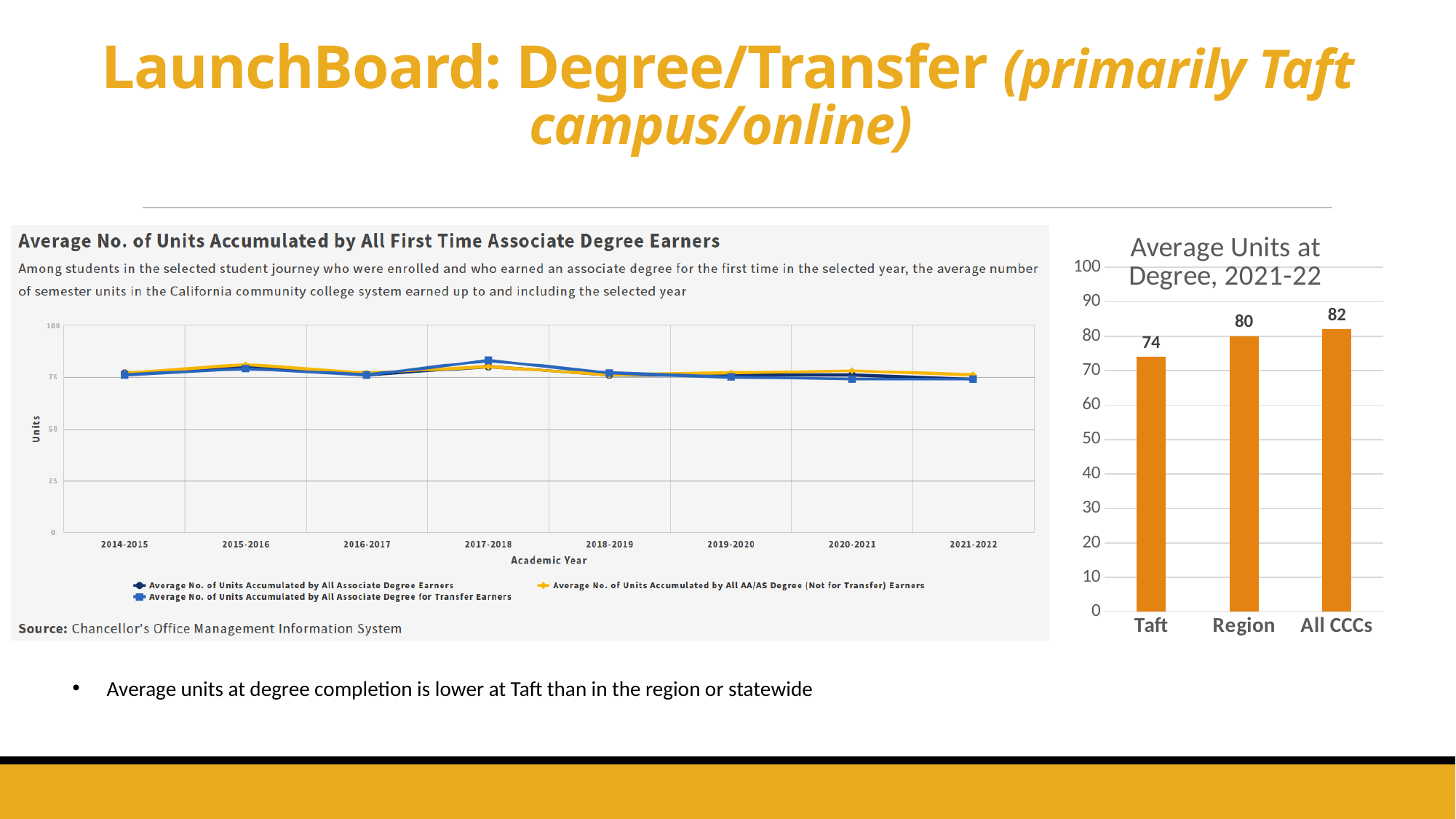
What kind of chart is the chart on the right of the slide? Bar chart In the 'Average Units at Degree, 2021-22' bar chart, what is the value for All CCCs? 82 In the 'Average Units at Degree, 2021-22' bar chart, which category has the lowest value? Taft In the 'Average Units at Degree, 2021-22' bar chart, what is the value for Region? 80 What kind of chart is the 'Average No. of Units Accumulated by All First Time Associate Degree Earners' chart on the left? Line chart In the 'Average Units at Degree, 2021-22' bar chart, which category has the highest value? All CCCs How many categories are shown in the 'Average Units at Degree, 2021-22' bar chart? 3 How many academic years are shown on the x axis of the 'Average No. of Units Accumulated by All First Time Associate Degree Earners' chart? 8 In the 'Average Units at Degree, 2021-22' bar chart, which is larger, the value for Region or the value for Taft? Region How many series does the legend of the 'Average No. of Units Accumulated by All First Time Associate Degree Earners' chart list? 3 In the 'Average Units at Degree, 2021-22' bar chart, what is the value for Taft? 74 In the 'Average Units at Degree, 2021-22' bar chart, what is the difference between the All CCCs value and the Taft value? 8